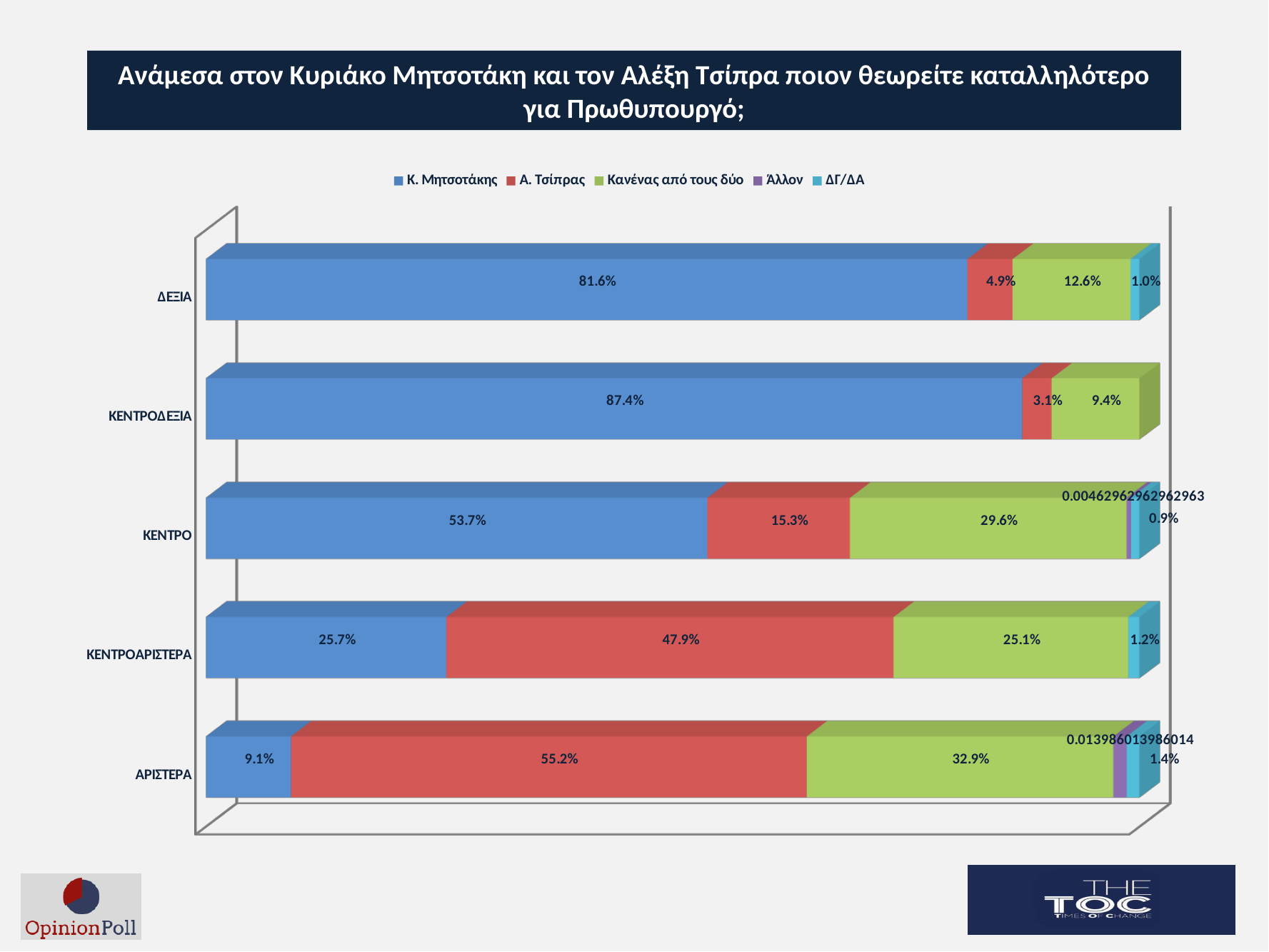
Which category has the lowest value for Α. Τσίπρας? ΚΕΝΤΡΟΔΕΞΙΑ What is the difference between the Κ. Μητσοτάκης value and the Α. Τσίπρας value in the ΚΕΝΤΡΟ category? 38.4% What is the value for Κ. Μητσοτάκης in the ΔΕΞΙΑ category? 81.6% How many series does the legend list? 5 What is the value for Κανένας από τους δύο in the ΑΡΙΣΤΕΡΑ category? 32.9% In the ΑΡΙΣΤΕΡΑ category, which is larger: the value for Α. Τσίπρας or the value for Κανένας από τους δύο? Α. Τσίπρας What kind of chart is shown on the slide? Stacked bar chart Which category has the highest value for Κ. Μητσοτάκης? ΚΕΝΤΡΟΔΕΞΙΑ What is the value for Α. Τσίπρας in the ΚΕΝΤΡΟΑΡΙΣΤΕΡΑ category? 47.9% Which series is shown in red in the legend? Α. Τσίπρας What is the value for ΔΓ/ΔΑ in the ΚΕΝΤΡΟ category? 0.9% How many categories are shown on the chart? 5